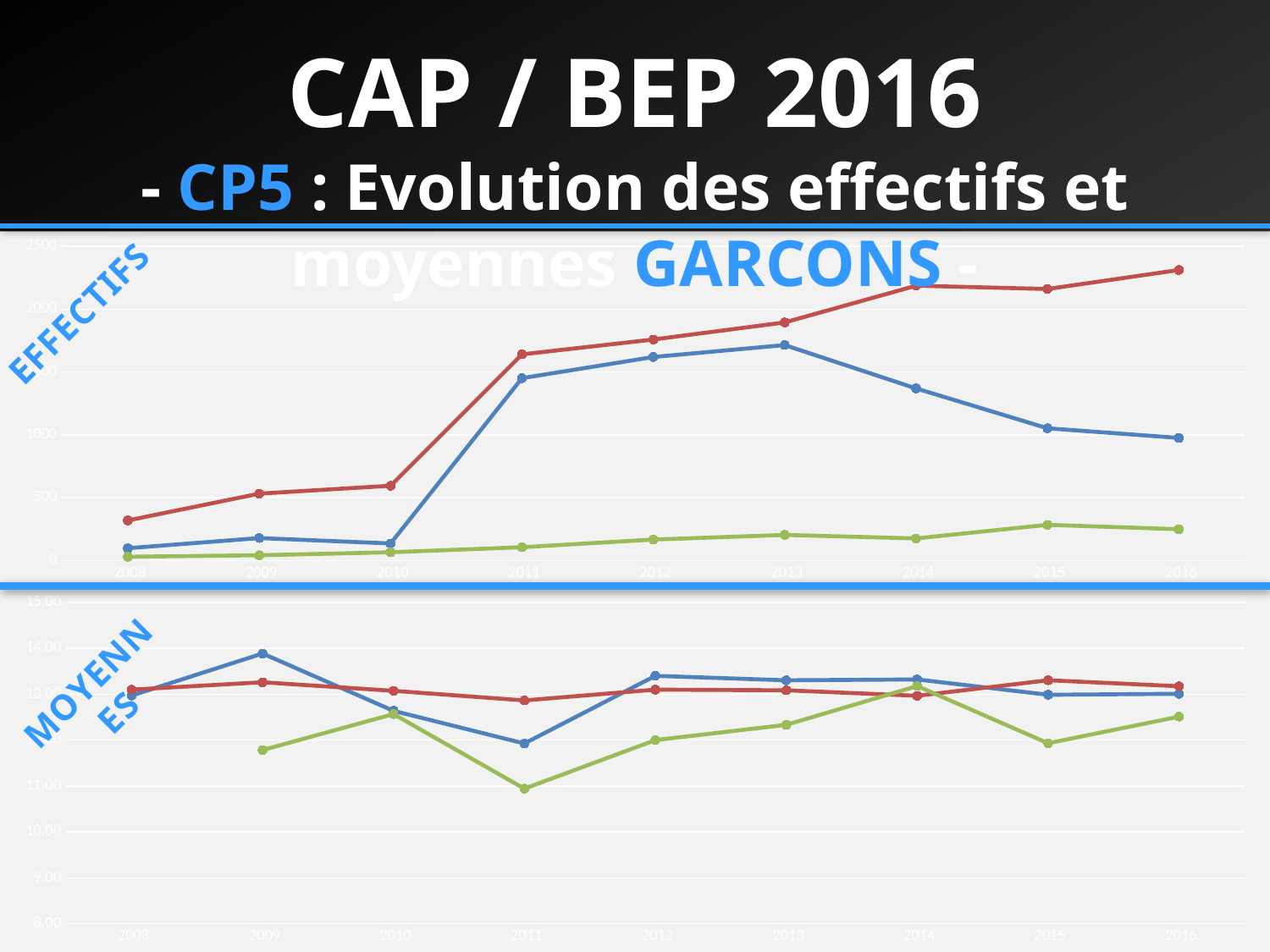
In the bottom chart (MOYENNES), in which year does the green line reach its lowest value? 2011 How many years are shown on the x axis of the top chart (EFFECTIFS)? 9 In the top chart (EFFECTIFS), in which year does the red line reach its highest value? 2016 In the bottom chart (MOYENNES), is the value of the green line in 2011 greater or less than 12.00? less In the top chart (EFFECTIFS), in 2011, which line is higher, the red line or the blue line? Red line In the top chart (EFFECTIFS), is the value of the red line in 2016 greater or less than 2000? greater In the top chart (EFFECTIFS), does the red line overall rise or fall from 2008 to 2016? Rise What kind of chart is the bottom chart labelled MOYENNES? Line chart What kind of chart is the top chart labelled EFFECTIFS? Line chart In the bottom chart (MOYENNES), in which year does the blue line reach its highest value? 2009 In the top chart (EFFECTIFS), is the value of the green line in 2016 greater or less than 500? less